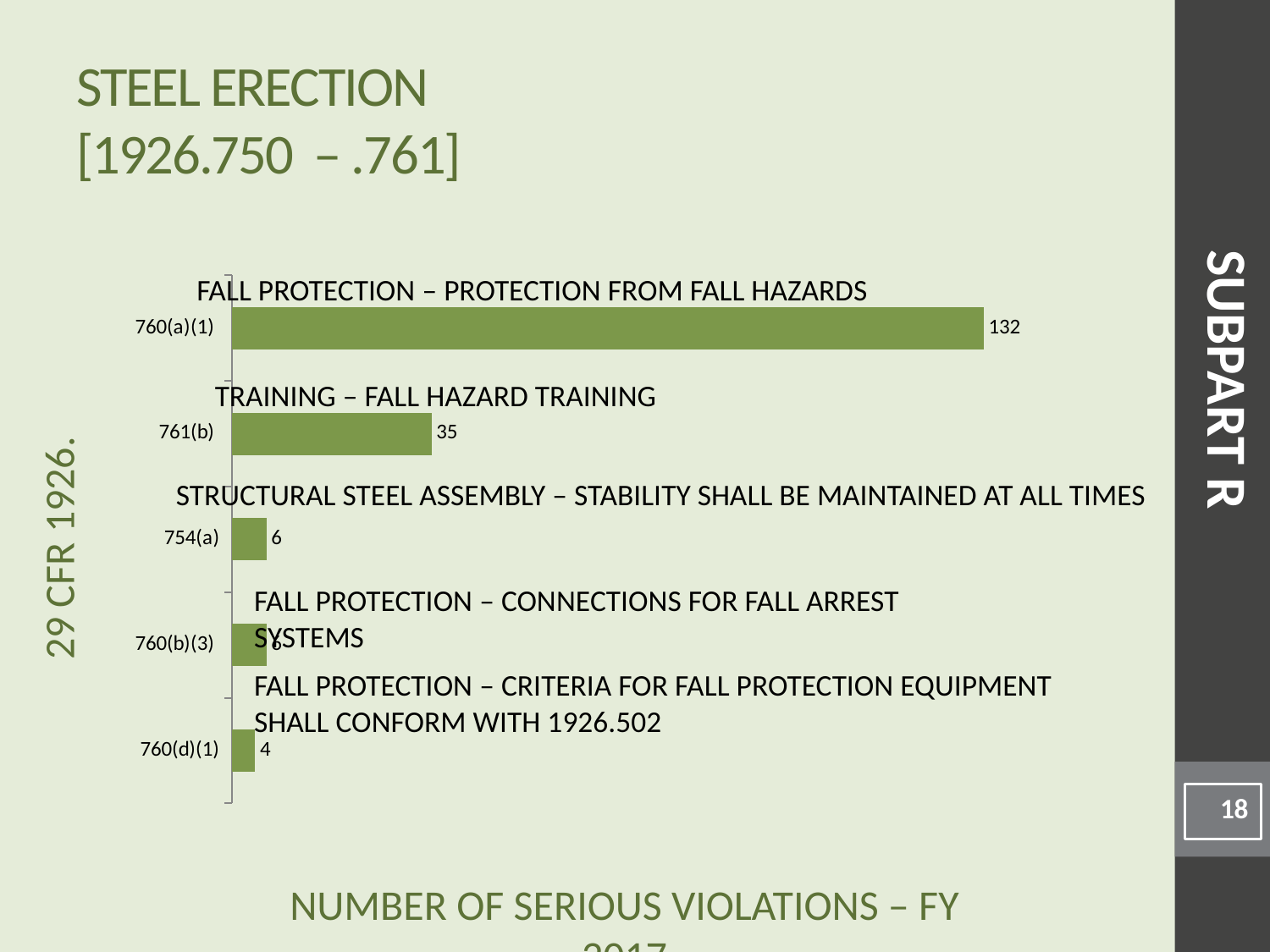
What description is shown above the bar for 761(b)? TRAINING – FALL HAZARD TRAINING How many standards (categories) are plotted in the chart? 5 What is the difference between the values for 760(a)(1) and 761(b)? 97 Which standard has the highest number of serious violations? 760(a)(1) What is the difference between the values for 761(b) and 754(a)? 29 What is the value for 754(a)? 6 Which has a larger value, 760(a)(1) or 760(d)(1)? 760(a)(1) What is the value for 760(d)(1)? 4 How many serious violations are shown for 760(a)(1)? 132 Which has a larger value, 761(b) or 754(a)? 761(b) What is the value for 761(b)? 35 What type of chart is shown on the slide? Bar chart